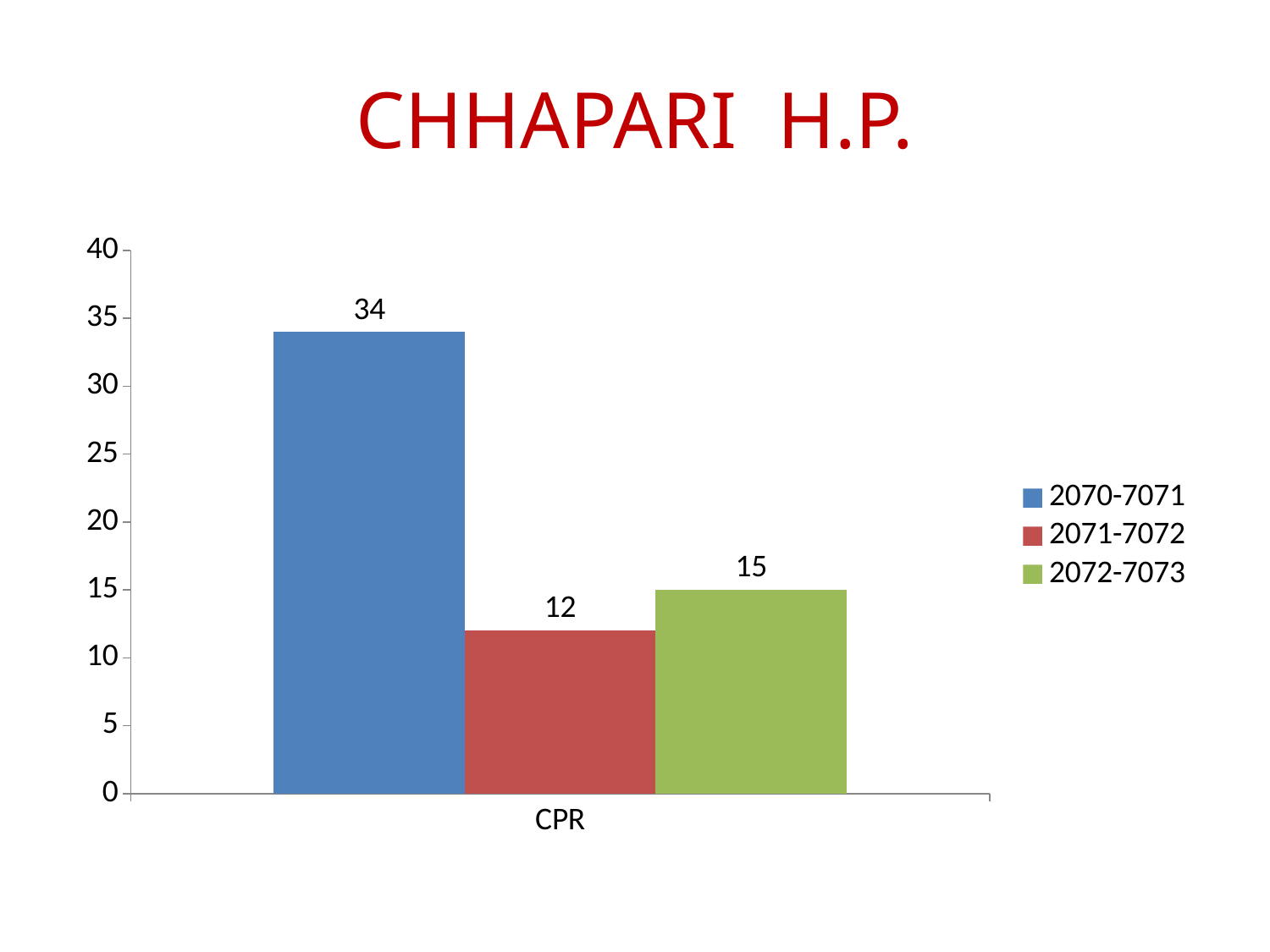
Which series has the lowest CPR value? 2071-7072 How many series does the legend list? 3 What kind of chart is shown on the slide? Bar chart What is the CPR value for the 2070-7071 series? 34 What is the CPR value for the 2072-7073 series? 15 Which series has the highest CPR value? 2070-7071 What is the CPR value for the 2071-7072 series? 12 What is the difference between the CPR values for 2072-7073 and 2071-7072? 3 Which is larger, the CPR value for 2071-7072 or for 2072-7073? 2072-7073 What is the category label shown on the x axis? CPR What is the title of the slide? CHHAPARI H.P. What is the difference between the CPR values for 2070-7071 and 2072-7073? 19